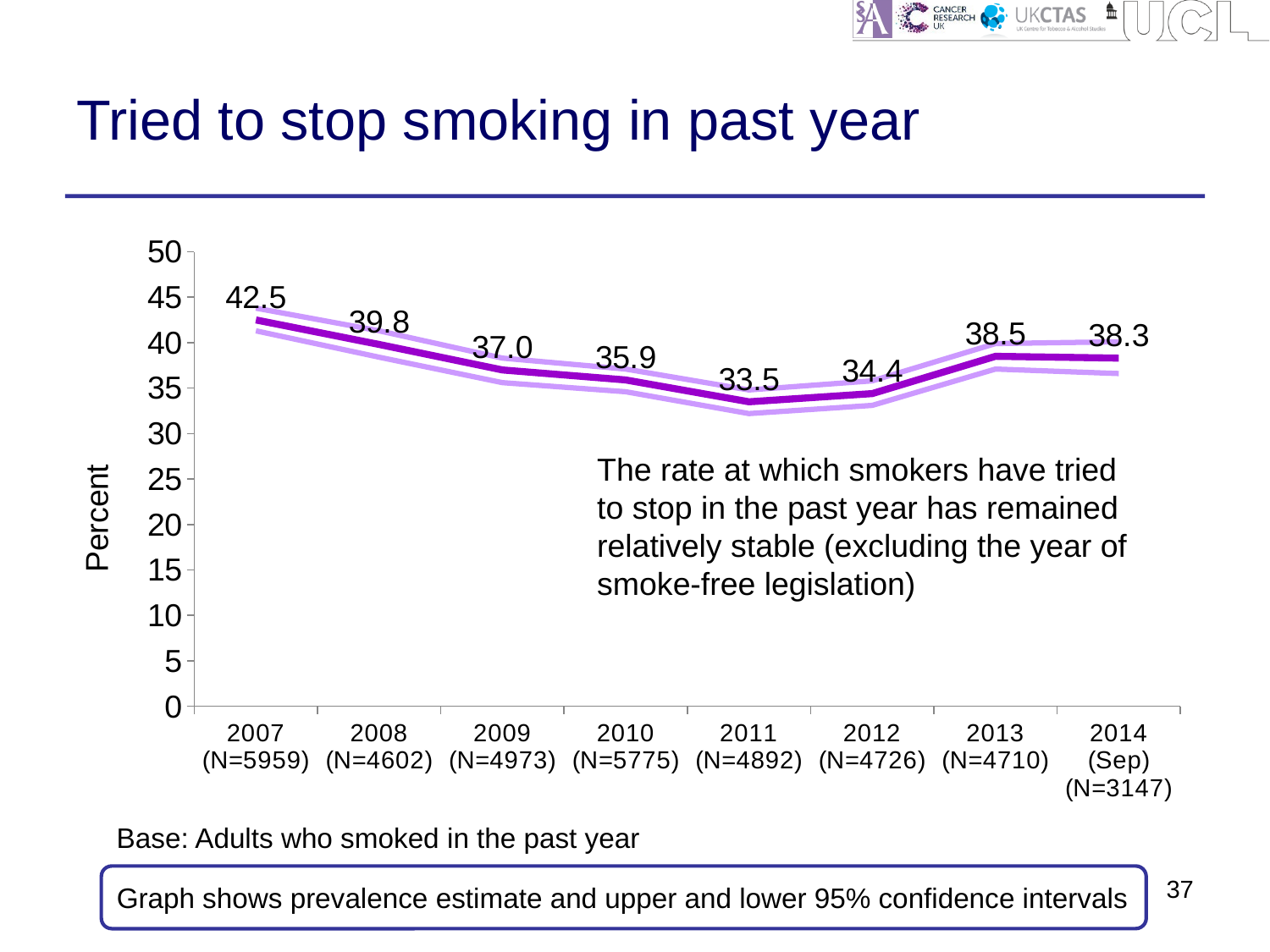
What is the value for 2011? 33.5 What is the difference between the values for 2007 and 2011? 9.0 What kind of chart is shown? line chart How many years are plotted on the x axis? 8 Which year has the highest value? 2007 Which year has the lowest value? 2011 Which is larger, the value for 2009 or the value for 2010? 2009 What is the difference between the values for 2013 and 2012? 4.1 What is the value for 2014 (Sep)? 38.3 Do the values rise or fall from 2007 to 2011? fall What is the value for 2007? 42.5 Is the value for 2008 greater or less than 35? greater